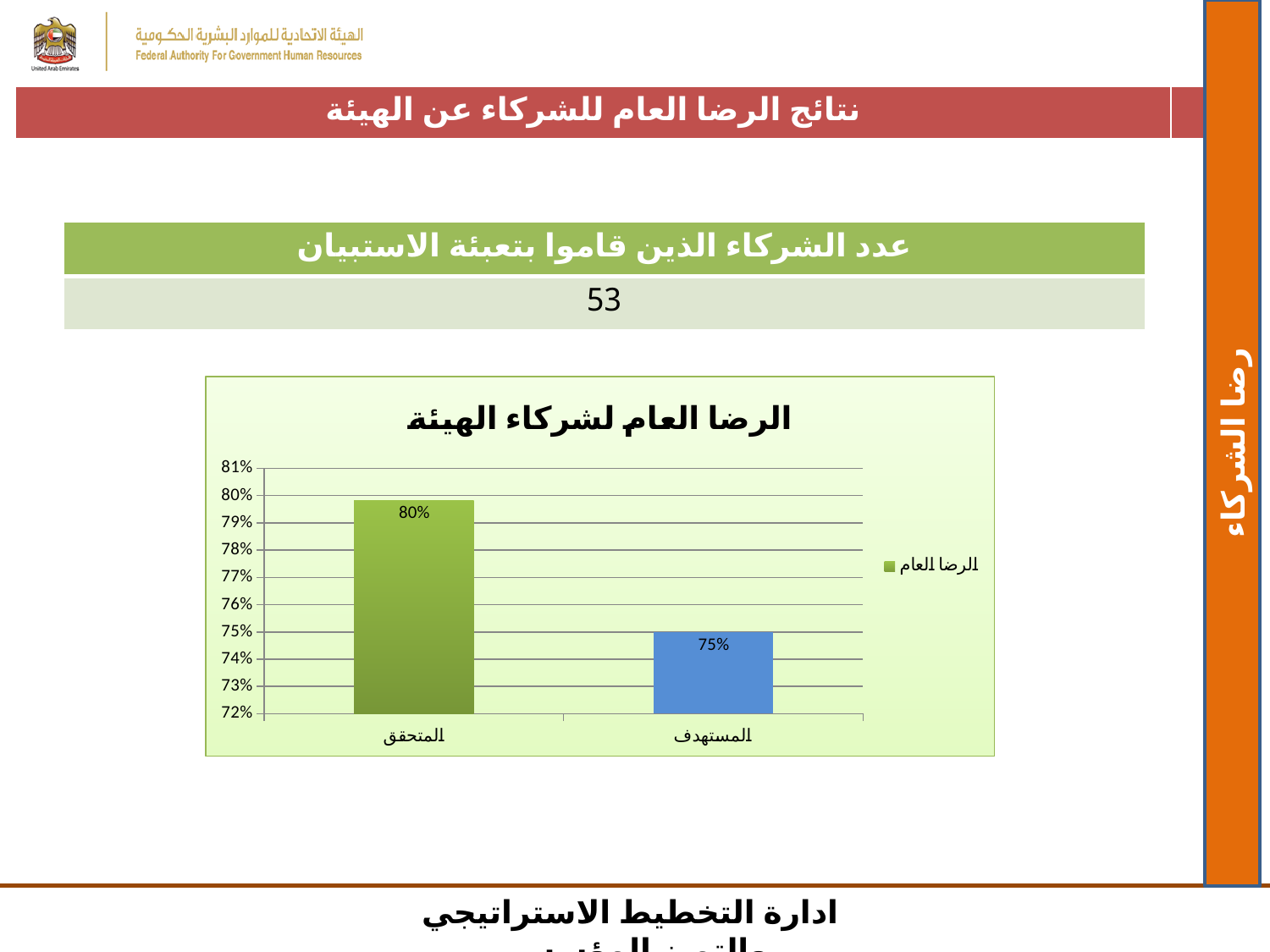
Is the value for المتحقق greater or less than 78%? greater What is the difference between the values for المتحقق and المستهدف? 5% Which category has the lowest value? المستهدف Is the value for المستهدف greater or less than 77%? less Which is larger, the value for المتحقق or the value for المستهدف? المتحقق What is the value for المتحقق? 80% How many categories are shown on the x axis? 2 Which category has the highest value? المتحقق What is the title of the chart? الرضا العام لشركاء الهيئة What kind of chart is shown? bar chart How many series does the legend list? 1 What is the value for المستهدف? 75%